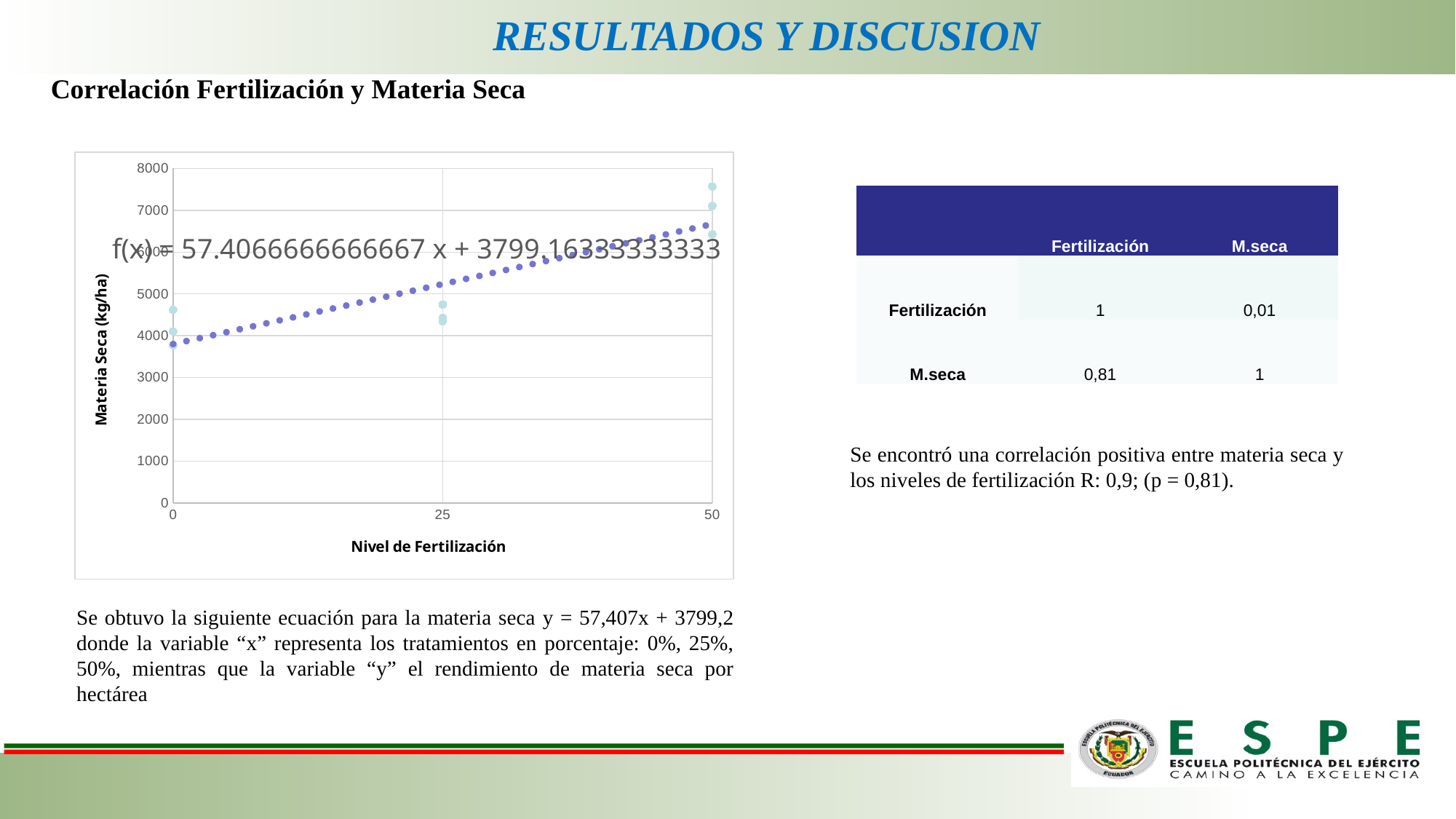
What is the label of the y axis of the chart? Materia Seca (kg/ha) What kind of chart is shown on the slide? scatter chart Is the highest plotted value at fertilization level 50 greater or less than 7000? greater Are all the plotted values at fertilization level 0 greater or less than 5000? less Are all the plotted values at fertilization level 25 greater or less than 4000? greater How many distinct fertilization levels are plotted on the x axis of the chart? 3 Which fertilization level has the highest plotted Materia Seca values? 50 What is the label of the x axis of the chart? Nivel de Fertilización Do the plotted values of Materia Seca rise or fall as Nivel de Fertilización increases from 0 to 50? rise What is the maximum value shown on the y axis of the chart? 8000